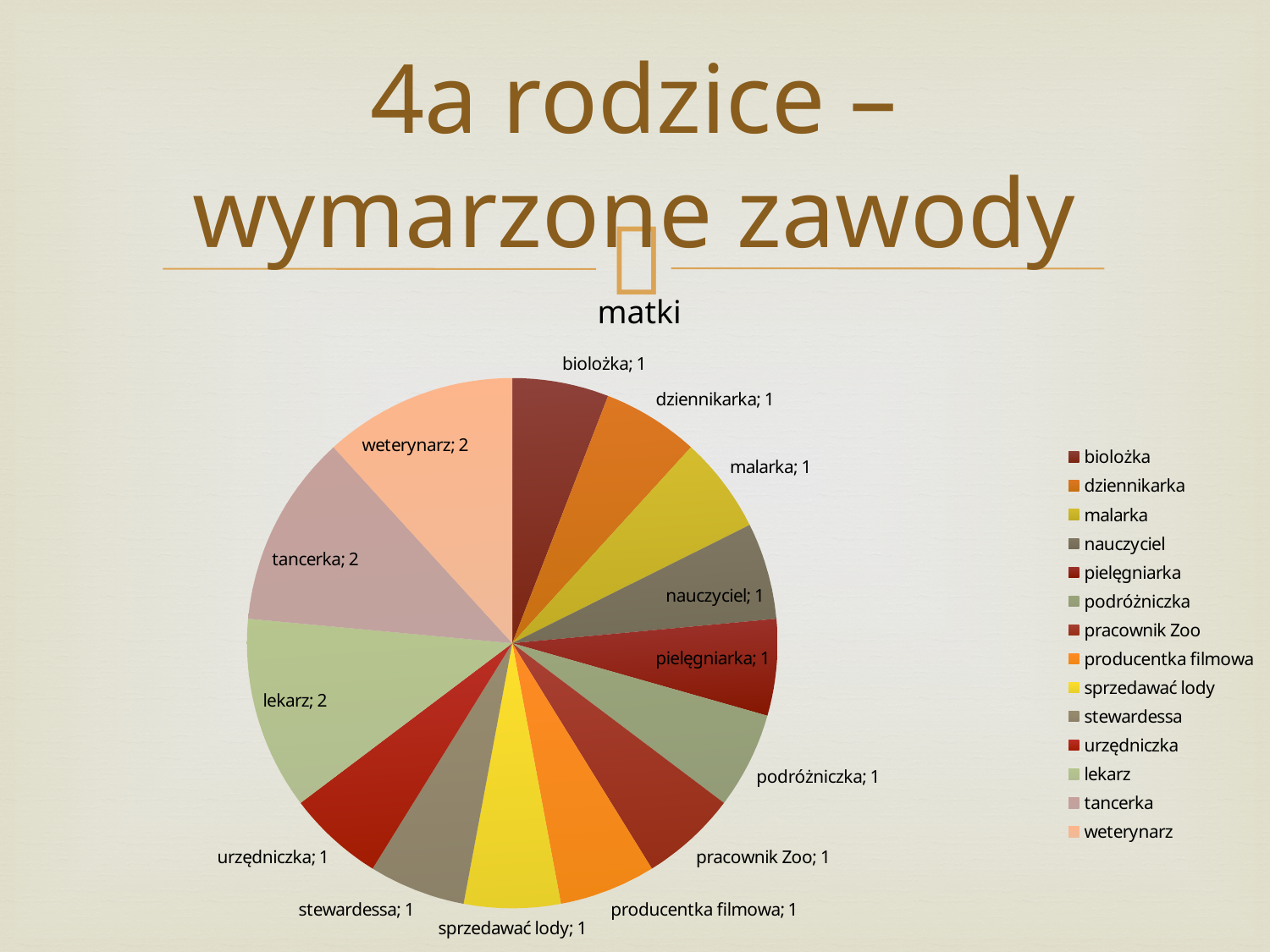
What is the total of all the values in the pie chart? 17 How many entries does the legend list? 14 How many categories does the pie chart have? 14 What is the title of the chart? matki What is the value for pielęgniarka? 1 Which categories share the highest value in the chart? lekarz, tancerka, weterynarz What is the value for sprzedawać lody? 1 What is the value for weterynarz? 2 What kind of chart is shown on the slide? pie chart What is the difference between the value for weterynarz and the value for biolożka? 1 Which is larger, the value for lekarz or the value for stewardessa? lekarz What is the value for tancerka? 2